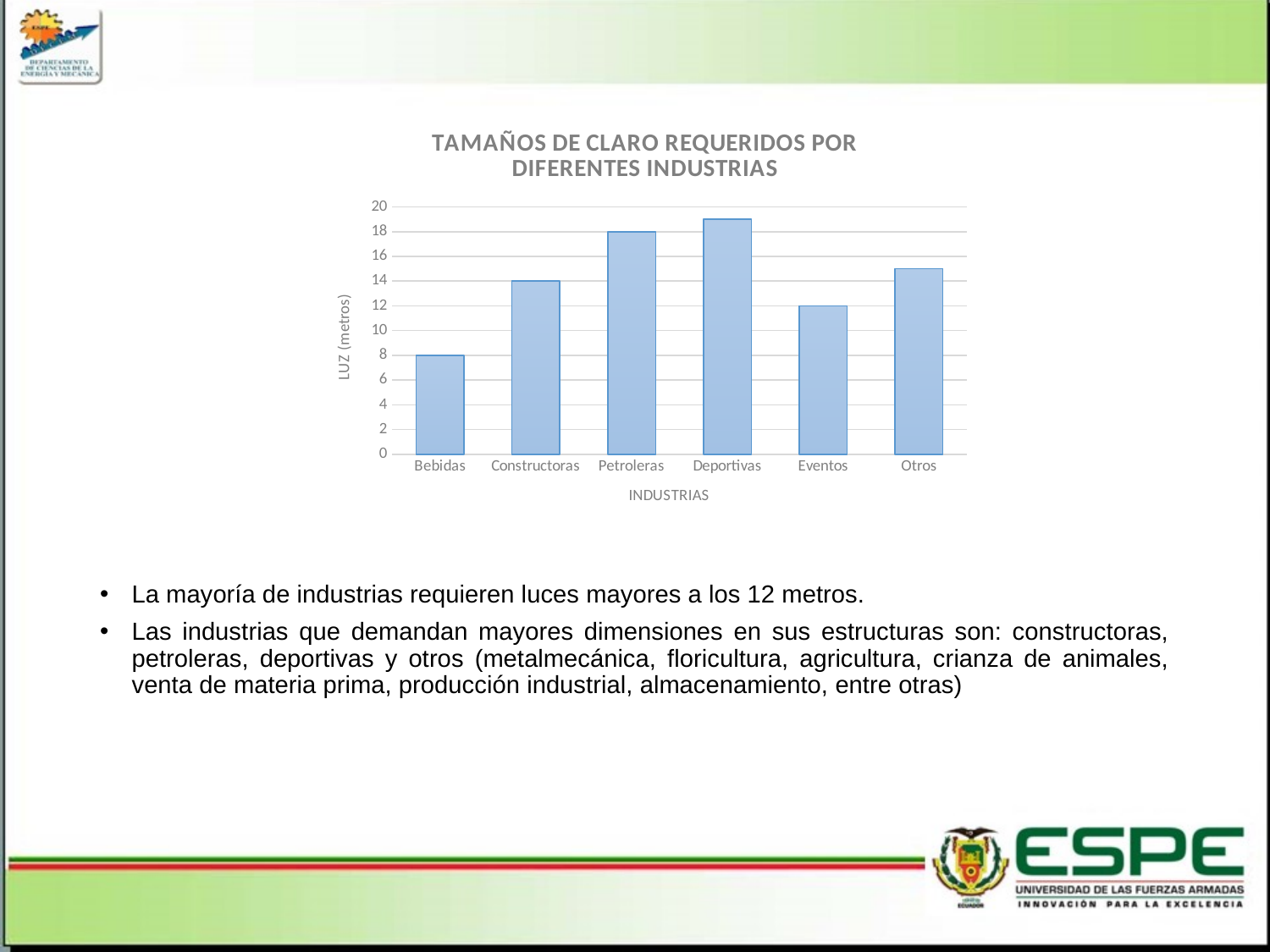
Is the value for Deportivas greater or less than 18? greater What is the value for Bebidas? 8 Which industry has the highest value? Deportivas Which is larger, the value for Constructoras or the value for Eventos? Constructoras What kind of chart is shown on the slide? bar chart Is the value for Otros greater or less than 16? less Which industry has the lowest value? Bebidas What is the value for Petroleras? 18 How many industries are shown on the x axis? 6 What is the value for Constructoras? 14 What is the difference between the values for Petroleras and Bebidas? 10 What is the value for Eventos? 12